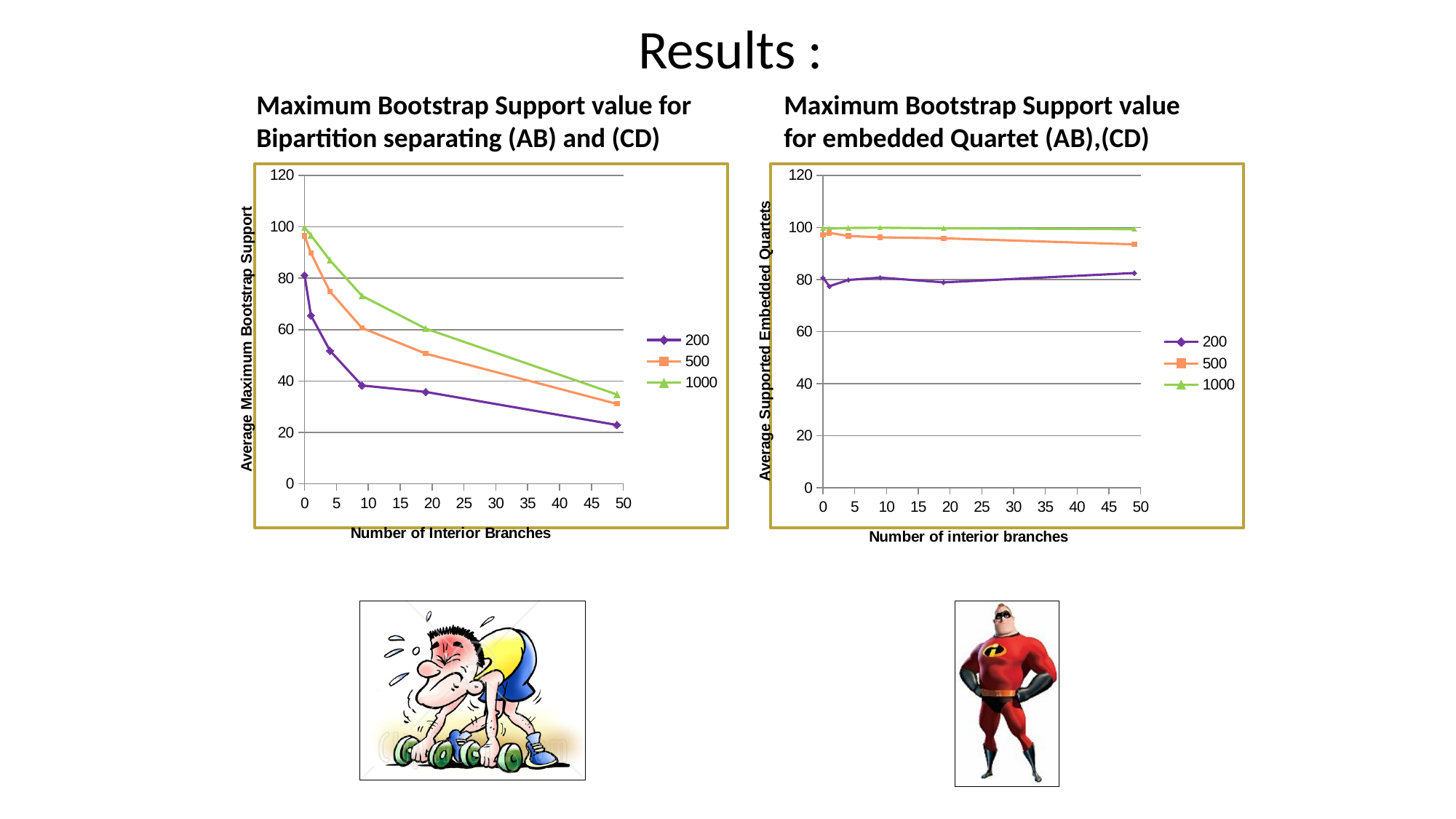
How many series does the legend of the right chart, 'Maximum Bootstrap Support value for embedded Quartet (AB),(CD)', list? 3 In the right chart, 'Maximum Bootstrap Support value for embedded Quartet (AB),(CD)', is the value of the 500 series at 50 interior branches greater or less than 80? greater In the right chart, 'Maximum Bootstrap Support value for embedded Quartet (AB),(CD)', which series has the higher value at 50 interior branches, 200 or 500? 500 In the left chart, 'Maximum Bootstrap Support value for Bipartition separating (AB) and (CD)', does the 200 series rise or fall as the number of interior branches increases? fall In the left chart, 'Maximum Bootstrap Support value for Bipartition separating (AB) and (CD)', is the value of the 1000 series at 0 interior branches greater or less than 80? greater In the left chart, 'Maximum Bootstrap Support value for Bipartition separating (AB) and (CD)', is the value of the 200 series at 50 interior branches greater or less than 40? less In the left chart, 'Maximum Bootstrap Support value for Bipartition separating (AB) and (CD)', which series has the lowest value at 50 interior branches? 200 In the left chart, 'Maximum Bootstrap Support value for Bipartition separating (AB) and (CD)', which series has the higher value at 20 interior branches, 500 or 1000? 1000 What kind of chart is the left chart, 'Maximum Bootstrap Support value for Bipartition separating (AB) and (CD)'? line chart What is the y-axis label of the right chart, 'Maximum Bootstrap Support value for embedded Quartet (AB),(CD)'? Average Supported Embedded Quartets In the left chart, 'Maximum Bootstrap Support value for Bipartition separating (AB) and (CD)', which series has the highest value at 10 interior branches? 1000